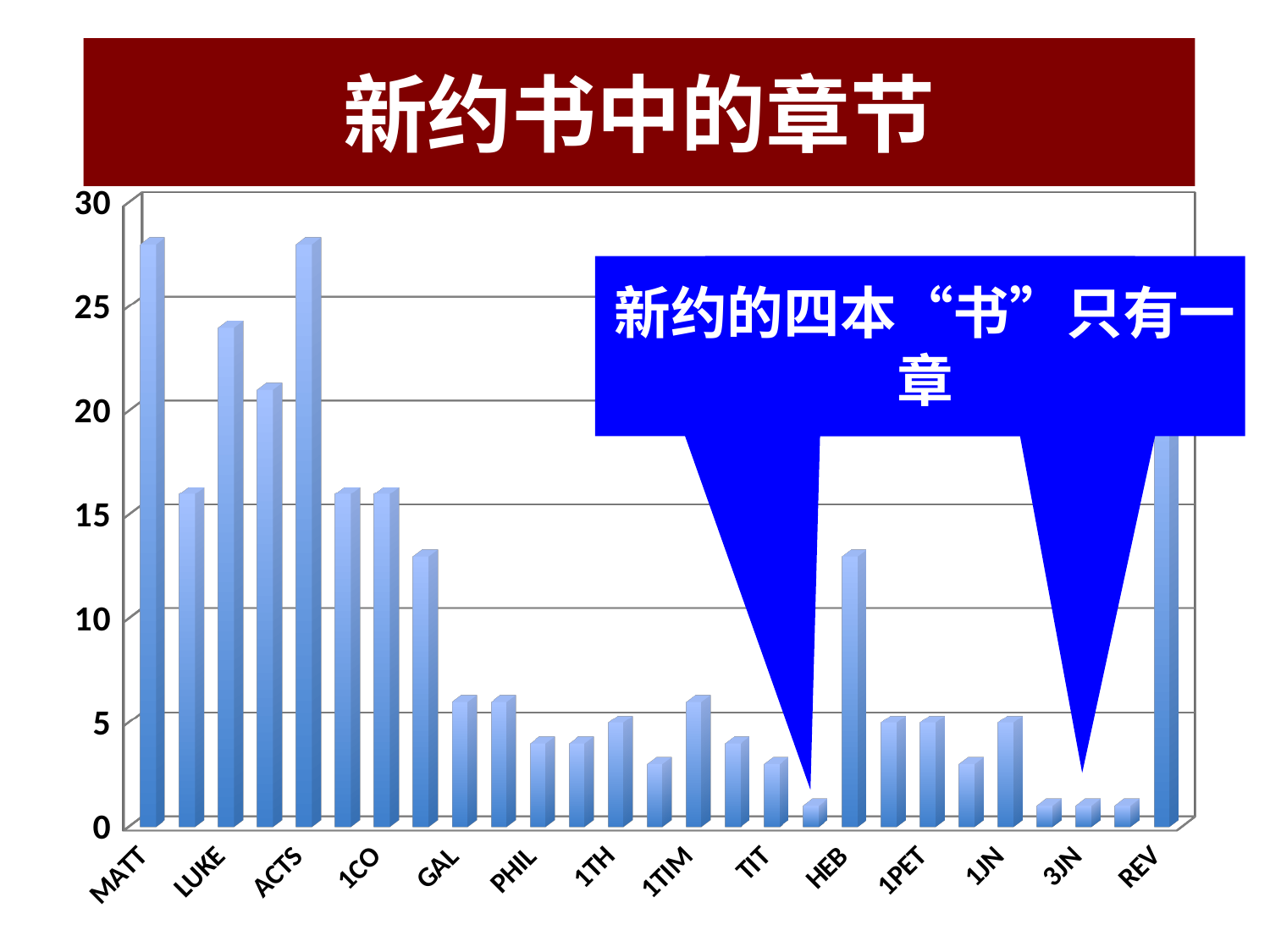
Is the value for LUKE greater or less than 25? less Is the value for HEB greater or less than 10? greater How many bars are plotted in the chart? 27 What does the blue callout on the chart say? 新约的四本“书”只有一章 Is the value for 3JN greater or less than 5? less Which is larger, the value for HEB or the value for GAL? HEB What is the title of the chart? 新约书中的章节 Which is larger, the value for MATT or the value for LUKE? MATT What kind of chart is shown on the slide? bar chart